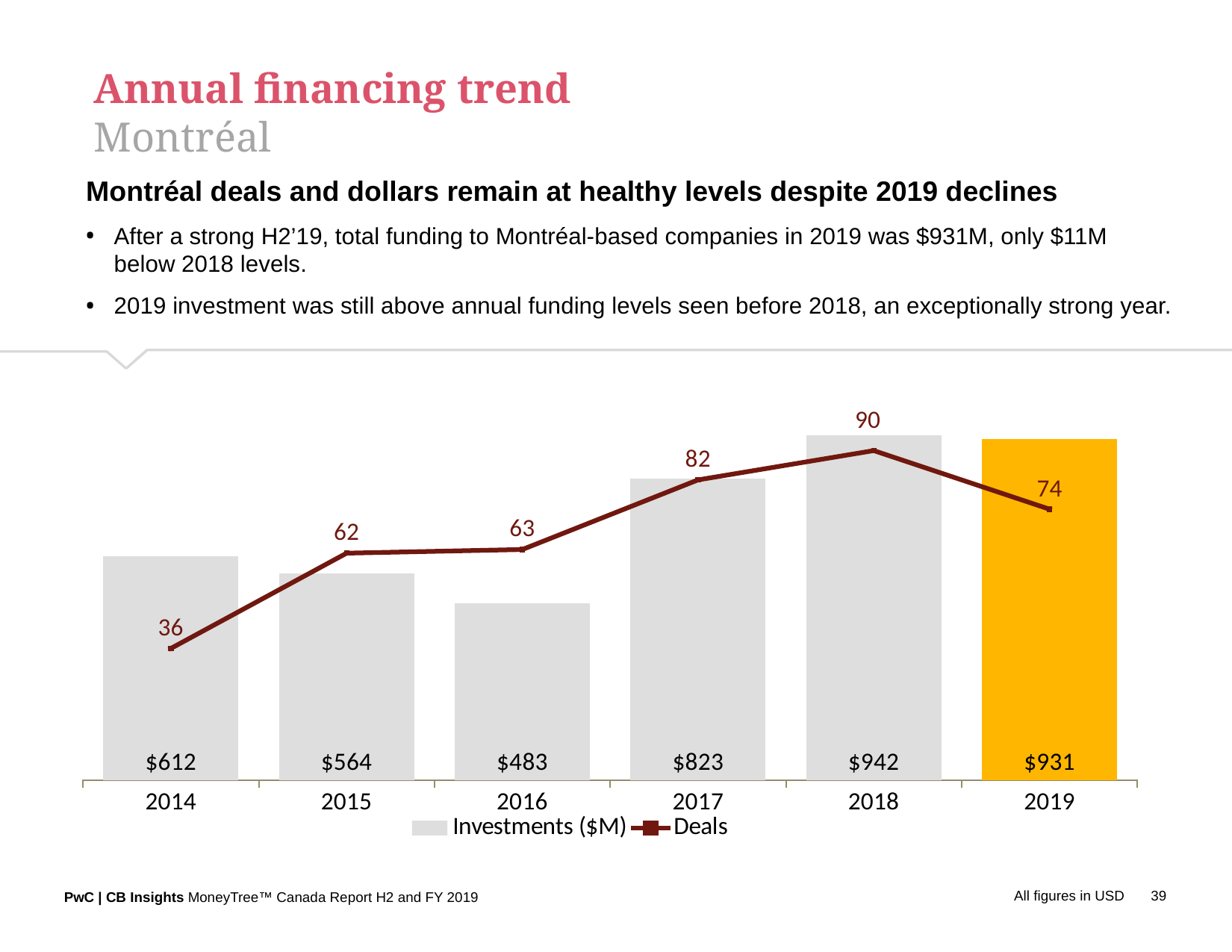
How many deals were there in 2015? 62 What is the difference in investments between 2018 and 2019? $11 Which year had a higher investment value, 2014 or 2015? 2014 What was the investment value for 2017? $823 Which year had the highest investment value? 2018 Did the number of deals rise or fall from 2014 to 2018? Rise How many series does the legend list? 2 What is the difference in the number of deals between 2018 and 2019? 16 What kind of chart is used to show the Investments ($M) series? Bar chart How many years are shown on the x axis? 6 Which year had more deals, 2016 or 2017? 2017 Which year had the lowest number of deals? 2014